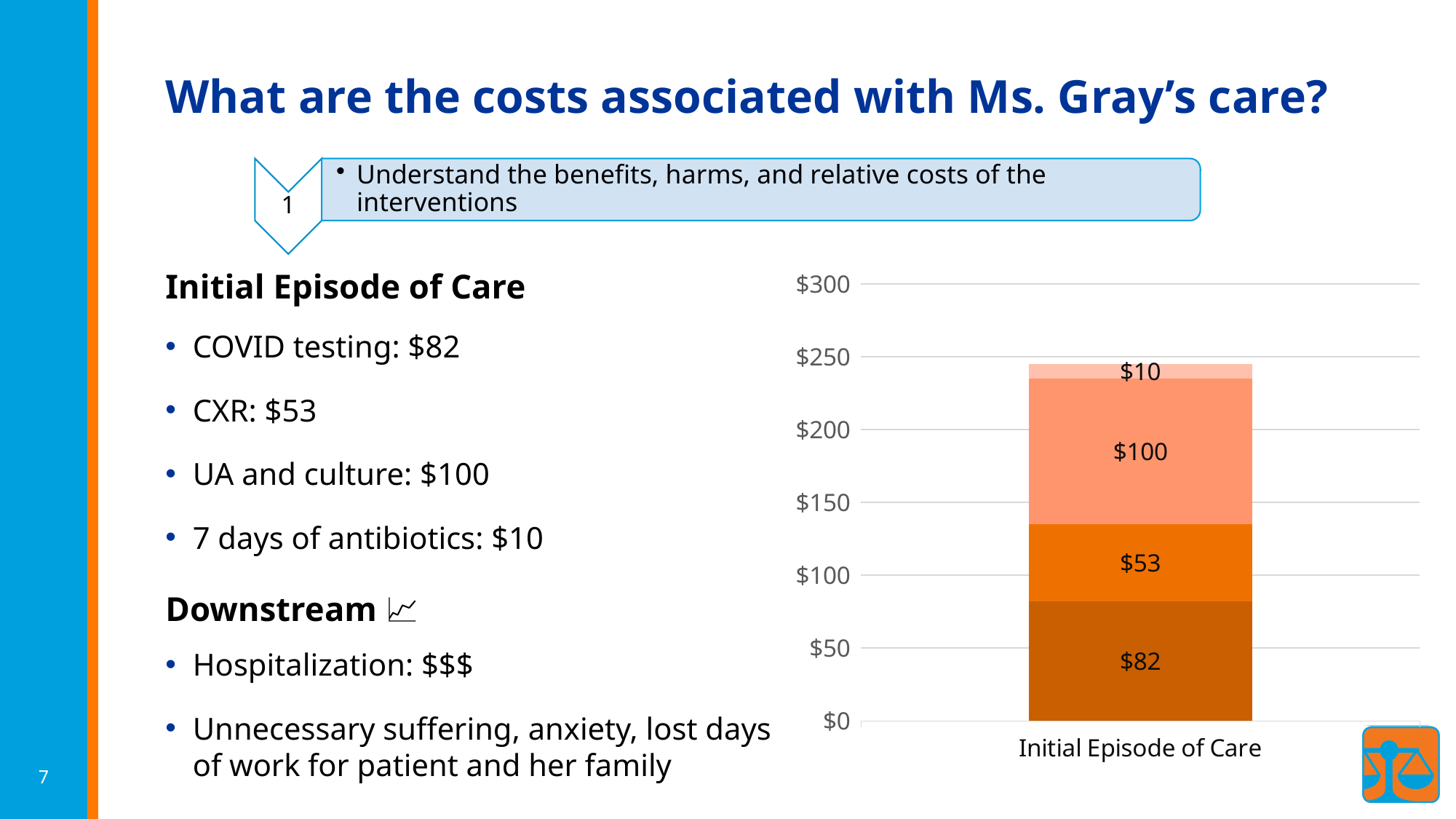
What is the value of the bottom (darkest) segment of the stacked bar? $82 What is the value of the top (lightest) segment of the stacked bar? $10 What is the value of the second segment from the bottom of the stacked bar? $53 What is the total of the stacked bar for Initial Episode of Care? $245 What is the category label on the x axis of the chart? Initial Episode of Care Is the total height of the stacked bar greater or less than $250? less What kind of chart is shown on the slide? Stacked bar chart What is the value of the smallest segment in the stacked bar? $10 Which is larger in the stacked bar: the $82 segment or the $53 segment? $82 segment How many categories are shown on the x axis of the chart? 1 What is the difference between the $100 segment and the $53 segment of the stacked bar? $47 What is the value of the largest segment in the stacked bar? $100